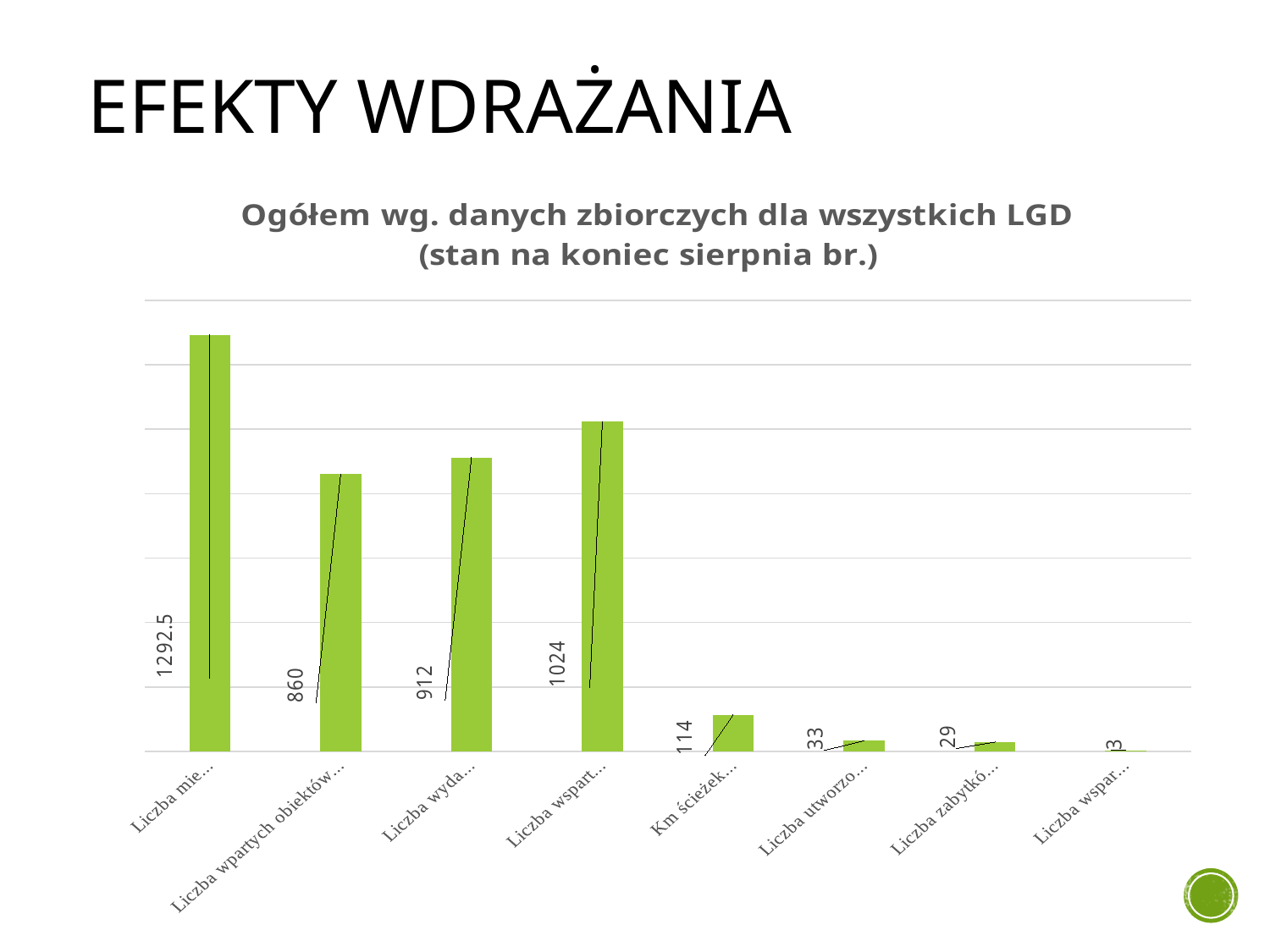
What is the value of the bar labelled 'Km ścieżek...'? 114 From the fifth bar to the eighth bar, do the values rise or fall? fall What type of chart is shown on the slide? bar chart What is the difference between the fourth bar (1024) and the third bar (912)? 112 What is the title of the chart? Ogółem wg. danych zbiorczych dla wszystkich LGD (stan na koniec sierpnia br.) Which bar has the lowest value in the chart? the last bar (Liczba wspar...), 3 Which is larger: the second bar from the left or the third bar from the left? the third bar (912) How many bars are plotted in the chart? 8 What is the value of the fourth bar from the left? 1024 Which bar has the highest value in the chart? the first bar (Liczba mie...), 1292.5 What is the value of the first (leftmost) bar in the chart? 1292.5 What is the value of the last (rightmost) bar in the chart? 3